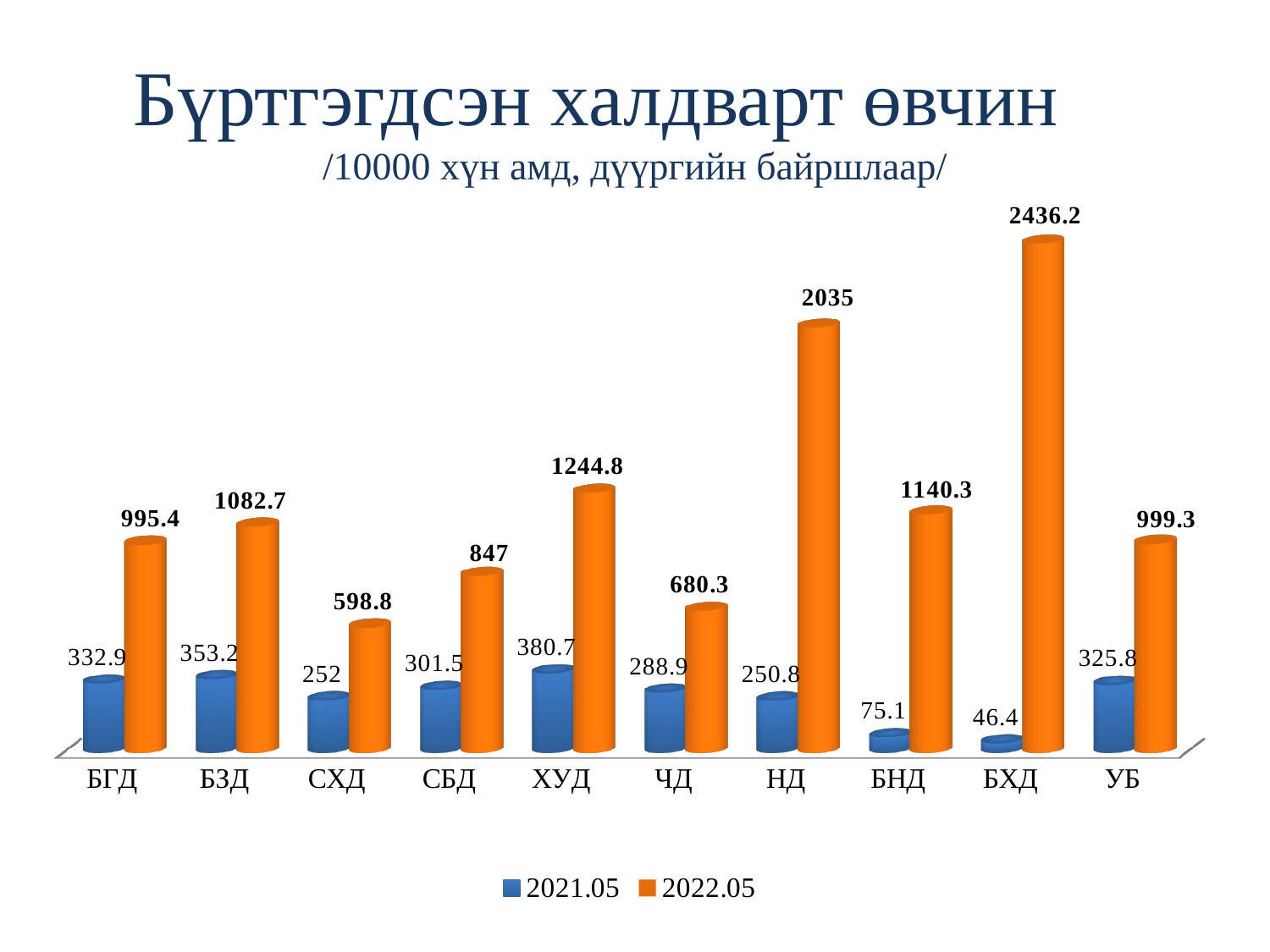
What is the value for БХД in the 2022.05 series? 2436.2 What is the difference between the 2022.05 values for ХУД and БЗД? 162.1 Which is larger: the 2022.05 value for НД or the 2022.05 value for БНД? НД How many series does the legend list? 2 Which category has the lowest value in the 2021.05 series? БХД Which category has the highest value in the 2022.05 series? БХД What is the difference between the 2022.05 and 2021.05 values for НД? 1784.2 What kind of chart is shown on the slide? Bar chart What is the value for СХД in the 2022.05 series? 598.8 Which category has the highest value in the 2021.05 series? ХУД How many categories are shown on the x axis? 10 What is the value for ХУД in the 2021.05 series? 380.7